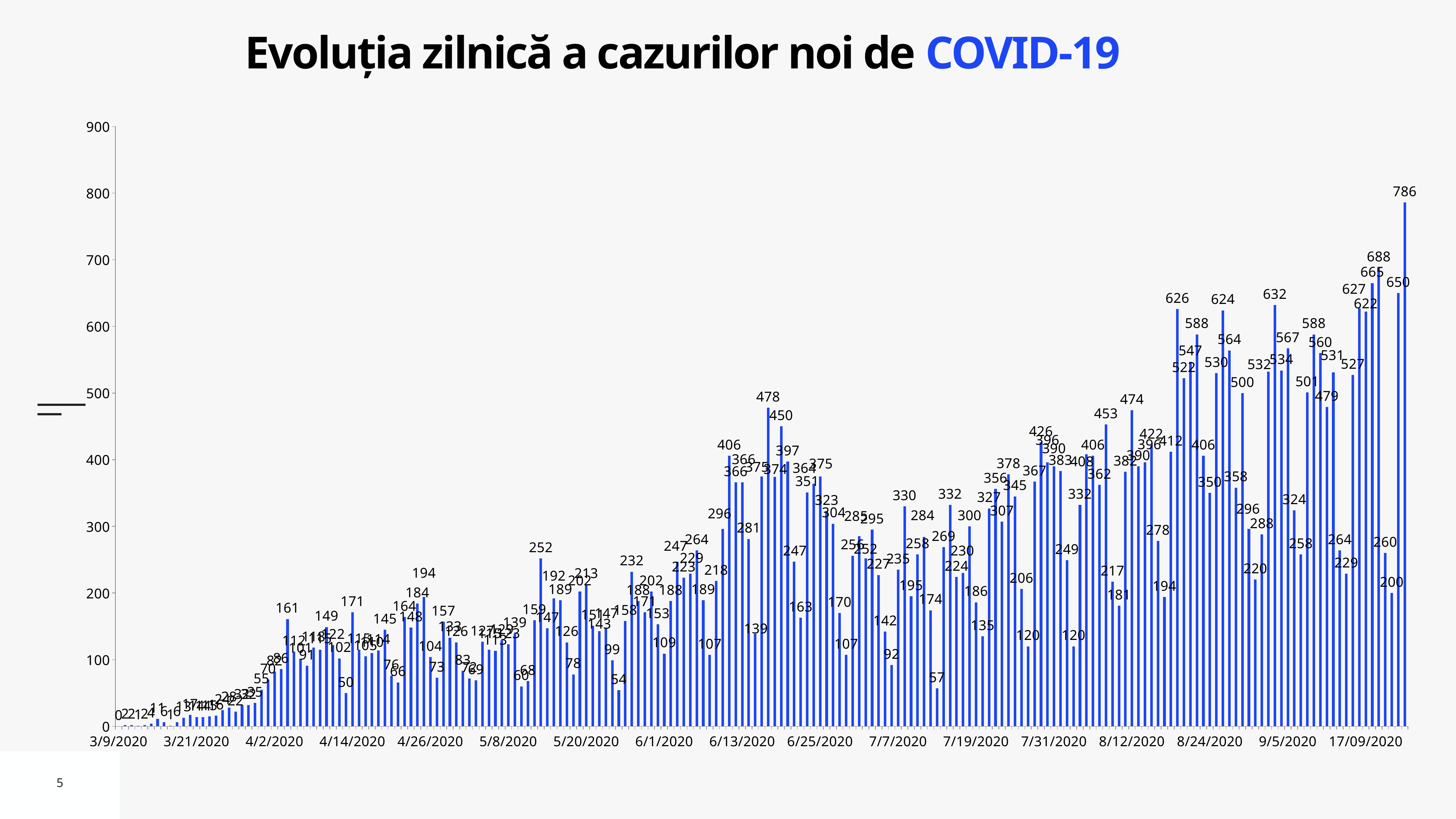
What is the highest value labeled on the chart? 786 What is the highest value labeled between the 6/13/2020 and 6/25/2020 ticks? 478 Is the highest bar on the chart greater or less than 700? greater Is the value for the first date, 3/9/2020, greater or less than 100? less What is the title of the chart? Evoluția zilnică a cazurilor noi de COVID-19 What is the difference between the highest labeled value (786) and the second highest (688)? 98 How many date labels are shown on the x axis? 17 What kind of chart is shown on the slide? bar chart Which is larger, the bar labeled 786 or the bar labeled 688? 786 What is the last date label on the x axis? 17/09/2020 What is the second highest value labeled on the chart? 688 Overall, do the values rise or fall from left to right along the x axis? rise